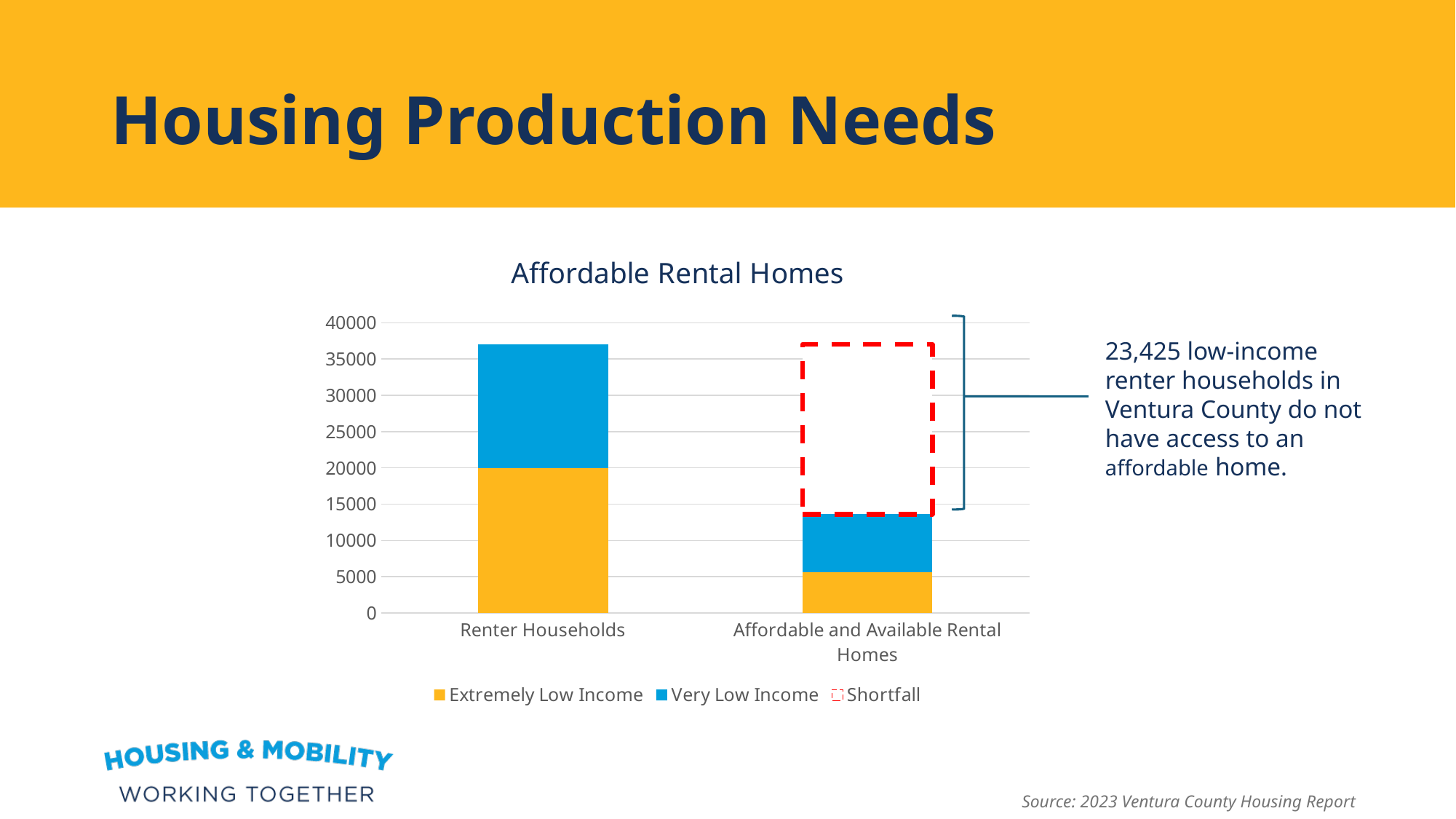
Is the total value for Renter Households greater or less than 35000? greater How many categories are shown on the x axis of the chart? 2 Is the Extremely Low Income value for Renter Households greater or less than 15000? greater What kind of chart is shown on the slide? Stacked bar chart Which legend entry is drawn as a red dashed outline? Shortfall Is the total value for Affordable and Available Rental Homes greater or less than 15000? less According to the annotation next to the chart, how many low-income renter households in Ventura County do not have access to an affordable home? 23,425 Which category has the taller stacked bar, Renter Households or Affordable and Available Rental Homes? Renter Households How many entries does the chart's legend list? 3 Which category has the lowest total bar height? Affordable and Available Rental Homes What is the title of the chart? Affordable Rental Homes